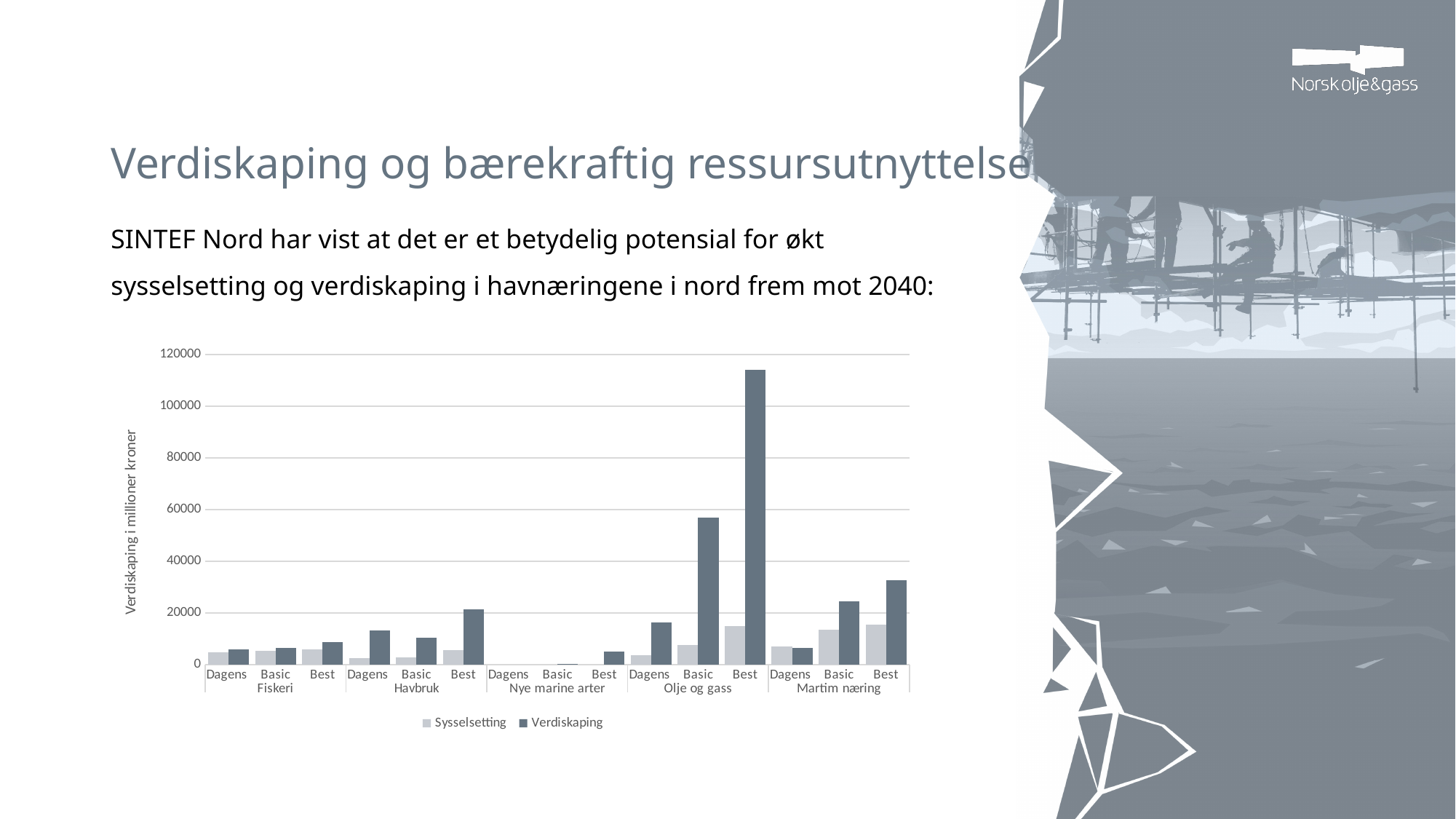
Within the Olje og gass group, do the Verdiskaping values rise or fall from Dagens to Basic to Best? rise Which is larger: the Verdiskaping value for Olje og gass Basic or for Martim næring Best? Olje og gass Basic Is the Verdiskaping value for Olje og gass Best greater or less than 100000? greater How many industry groups are shown along the x axis of the chart? 5 How many bars are plotted for the Verdiskaping series in the chart? 14 How many series does the chart legend list? 2 What is the title of the vertical axis of the chart? Verdiskaping i millioner kroner Is the Verdiskaping value for Martim næring Best greater or less than 40000? less Is the Verdiskaping value for Olje og gass Basic greater or less than 40000? greater What kind of chart is shown on the slide? bar chart Which category has the highest Verdiskaping value in the chart? Olje og gass, Best Which two series are listed in the chart legend? Sysselsetting and Verdiskaping